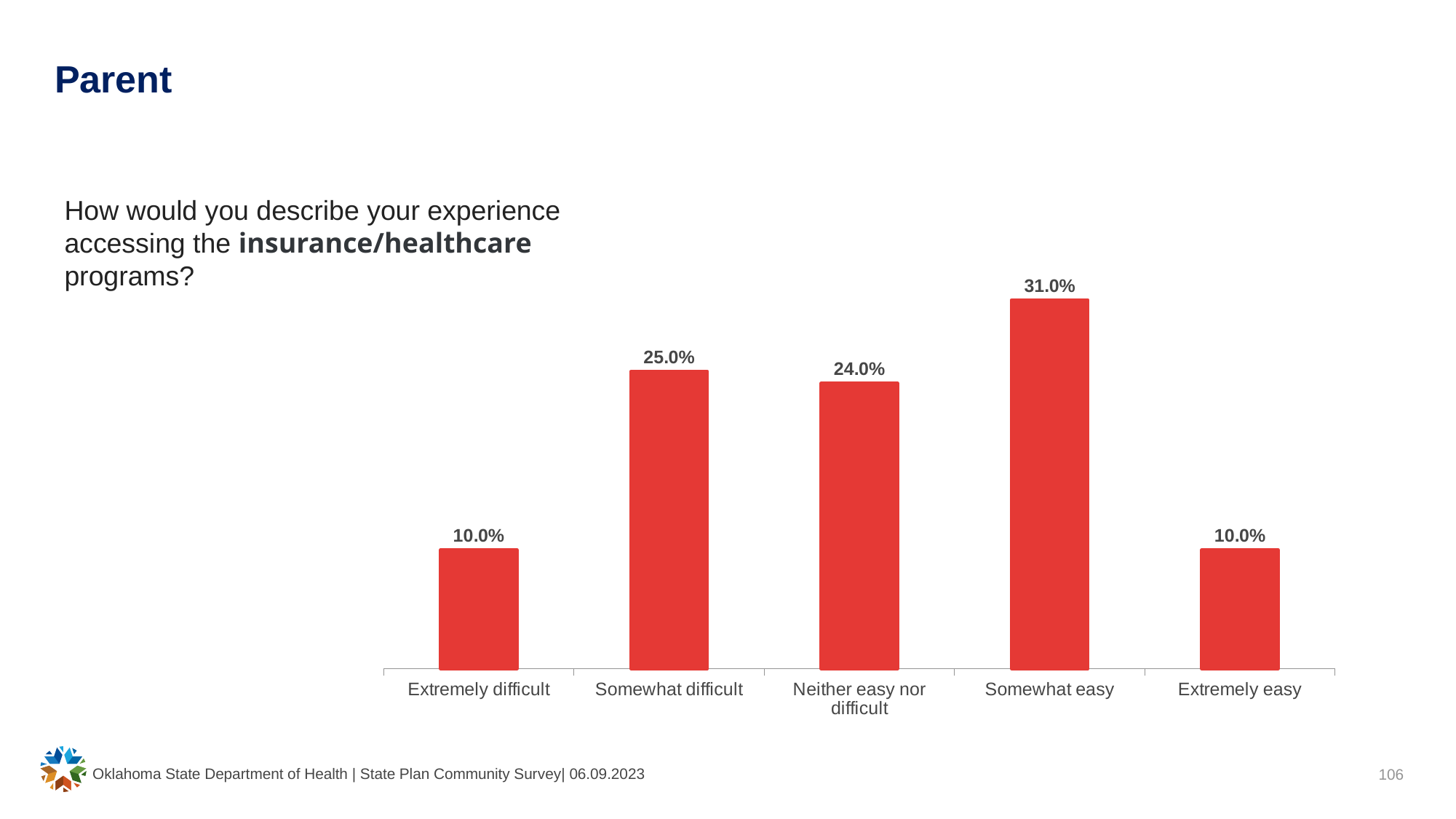
What is the difference between the Somewhat easy and Somewhat difficult values? 6.0% What is the difference between the Somewhat difficult and Extremely difficult values? 15.0% What is the combined value of Somewhat easy and Extremely easy? 41.0% What is the value shown for Extremely difficult? 10.0% Which response category has the highest value? Somewhat easy What is the value shown for Somewhat difficult? 25.0% What percentage of parents described their experience accessing insurance/healthcare programs as Somewhat easy? 31.0% What is the value shown for Neither easy nor difficult? 24.0% What kind of chart is shown on the slide? Bar chart Which response categories share the lowest value? Extremely difficult and Extremely easy How many response categories are shown on the x axis? 5 Which is larger, the value for Somewhat easy or the value for Neither easy nor difficult? Somewhat easy